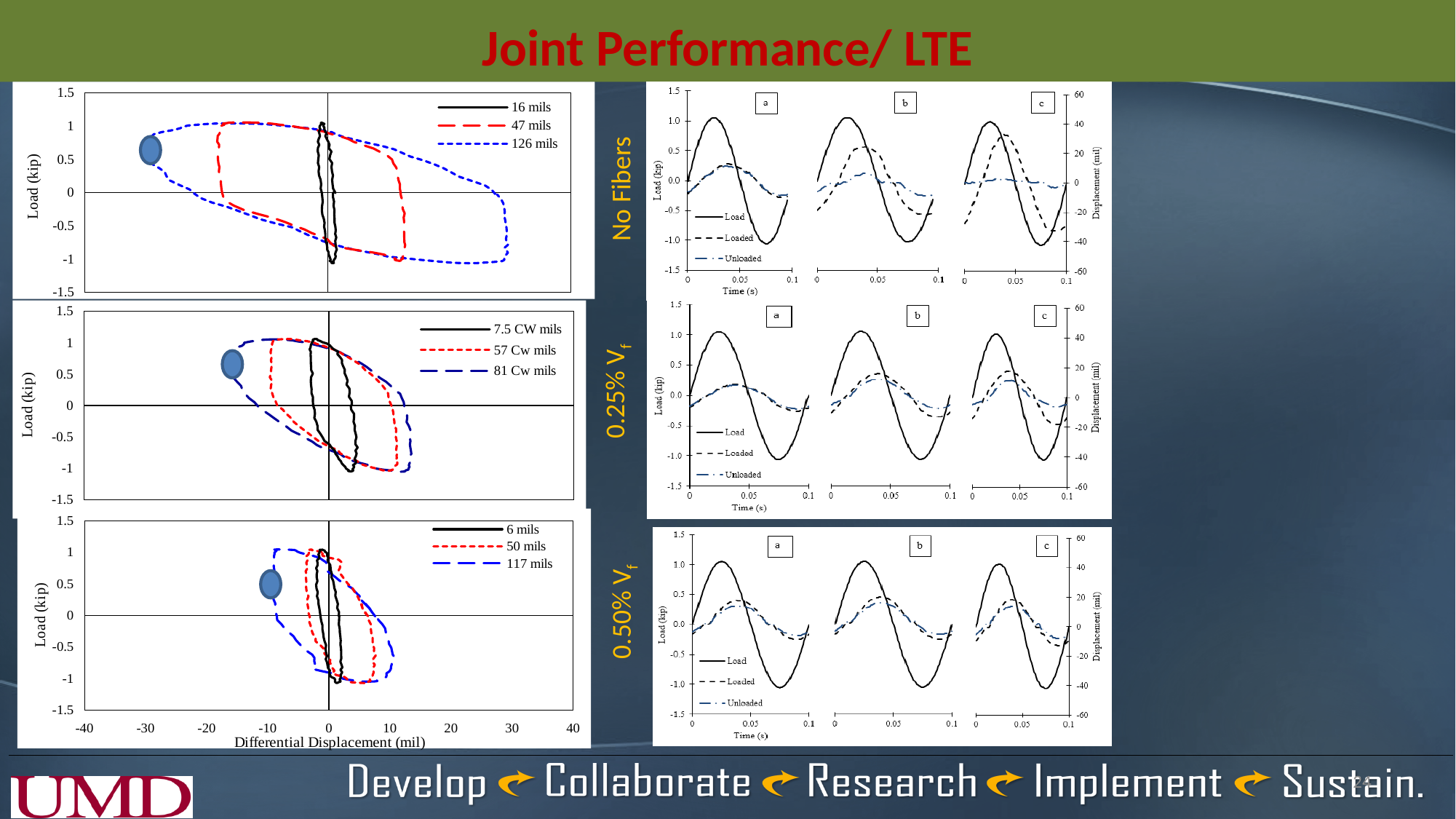
How many panels (a, b, c) does the 0.25% Vf chart on the right contain? 3 In the middle-left chart, which series has the narrowest loop in differential displacement? 7.5 CW mils In the No Fibers chart on the right, how many series does the legend list? 3 In the bottom-left chart, which loop is wider in differential displacement, 50 mils or 117 mils? 117 mils What kind of chart is the middle-left chart with the 7.5 CW mils, 57 Cw mils and 81 Cw mils series? Line chart In the top-left chart, is the maximum differential displacement reached by the 126 mils loop greater or less than 20? greater In the top-left chart, which series has the widest loop in differential displacement? 126 mils In the top-left Load vs Differential Displacement chart, how many series does the legend list? 3 In panel a of the 0.50% Vf chart, is the peak of the Load curve greater or less than 0.5 kip? greater In the bottom-left chart, is the maximum differential displacement reached by the 6 mils loop greater or less than 10? less What is the x-axis label of the bottom-left chart? Differential Displacement (mil) In the top-left Load vs Differential Displacement chart, what are the legend entries? 16 mils, 47 mils, 126 mils